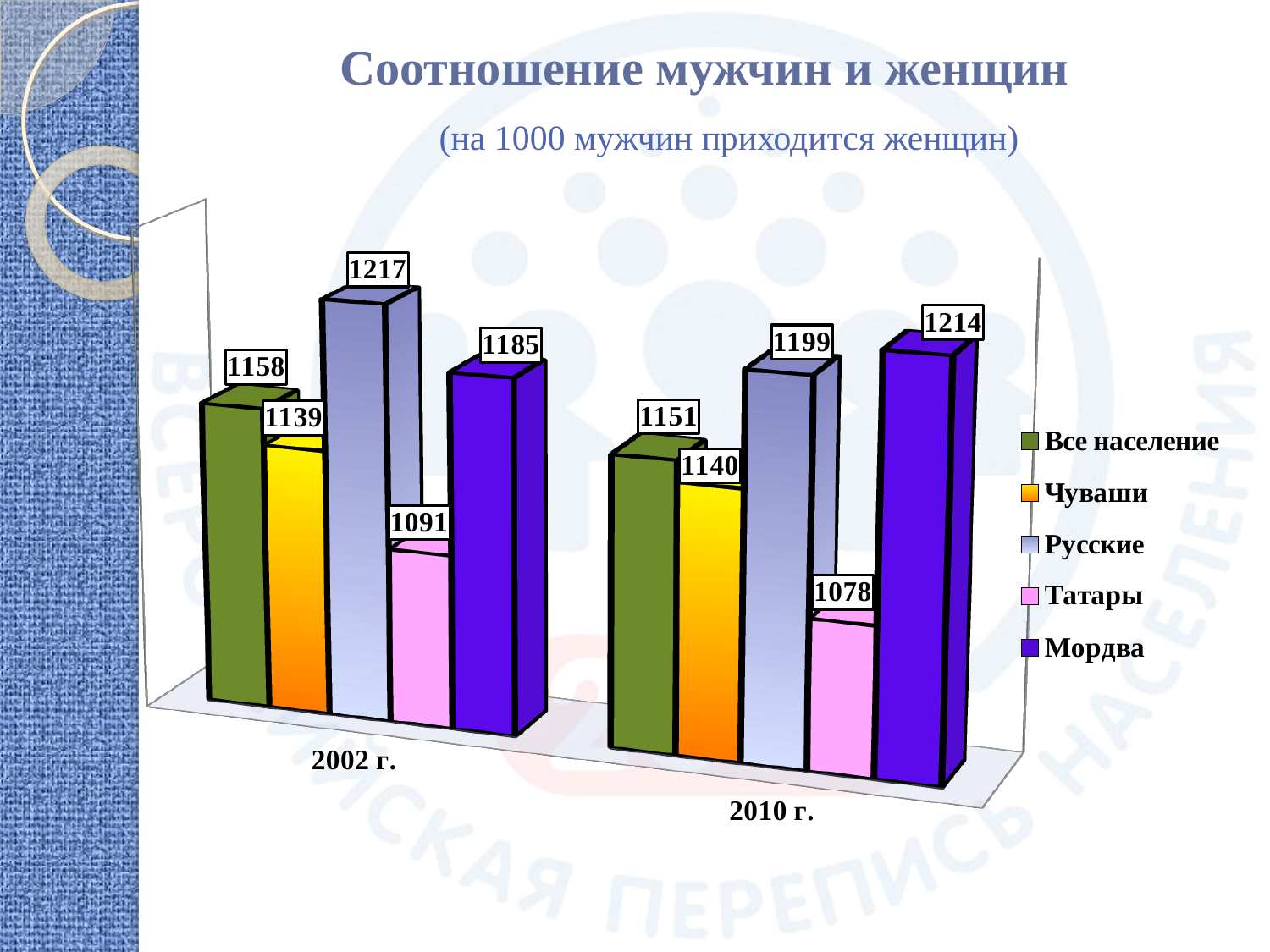
Which series has the lowest value in 2002 г.? Татары What is the value for Все население in 2002 г.? 1158 What is the title of the chart? Соотношение мужчин и женщин What is the value for Татары in 2010 г.? 1078 Which is larger: the value for Чуваши in 2002 г. or in 2010 г.? 2010 г. How many series does the legend list? 5 Which series has the highest value in 2010 г.? Мордва What kind of chart is shown on the slide? Bar chart How many year categories are shown on the x axis? 2 What is the value for Русские in 2002 г.? 1217 What is the value for Мордва in 2010 г.? 1214 What is the difference between the Русские values for 2002 г. and 2010 г.? 18